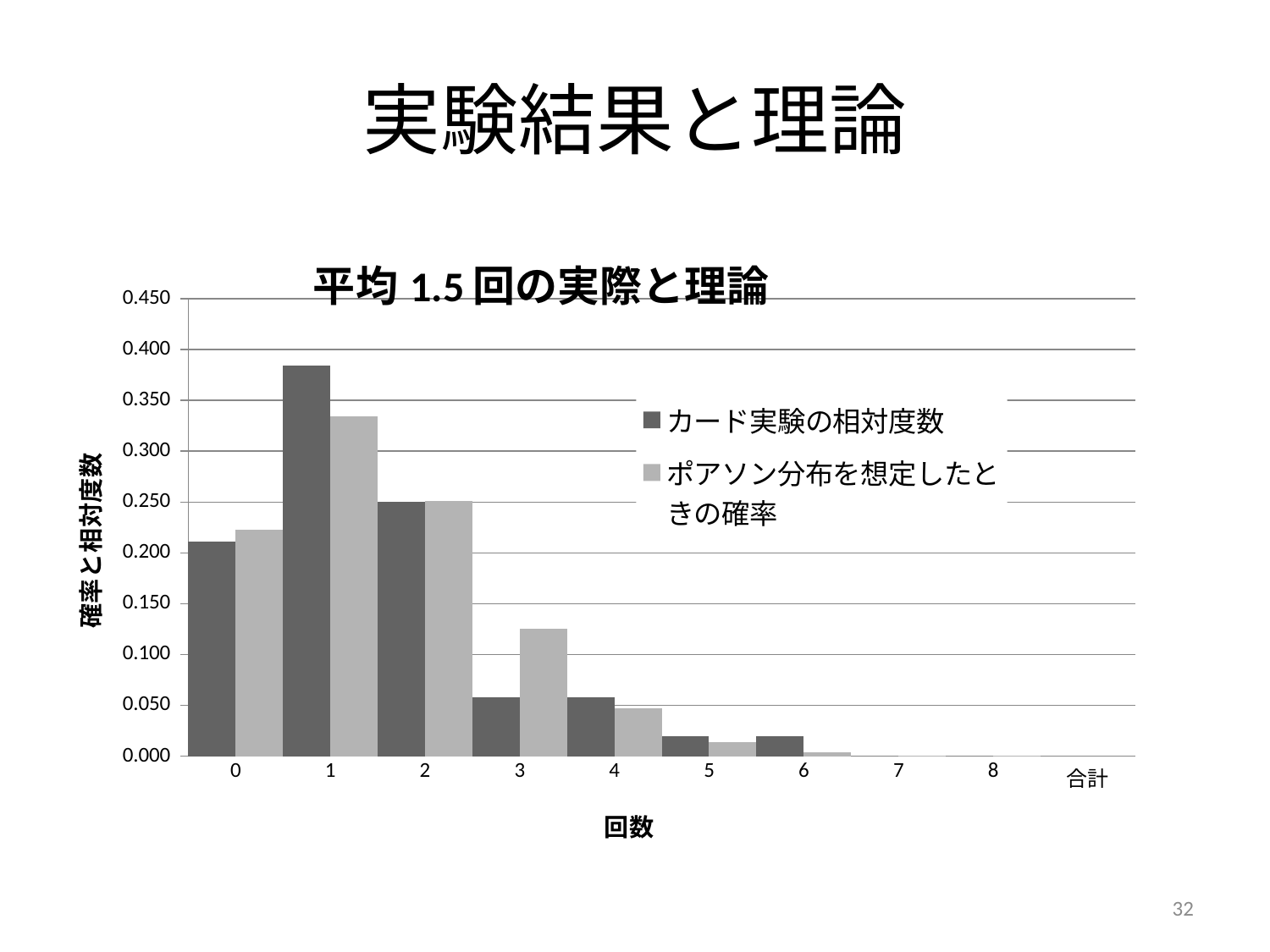
How many categories are shown on the x axis? 10 At 回数 = 3, which series has the larger value, カード実験の相対度数 or ポアソン分布を想定したときの確率? ポアソン分布を想定したときの確率 What is the title of the chart? 平均 1.5 回の実際と理論 What kind of chart is shown on the slide? bar chart Is the value of カード実験の相対度数 at 回数 = 1 greater or less than 0.350? greater Is the value of ポアソン分布を想定したときの確率 at 回数 = 3 greater or less than 0.100? greater What is the label of the x axis? 回数 For the series カード実験の相対度数, which 回数 category has the highest value? 1 For the series ポアソン分布を想定したときの確率, which 回数 category has the highest value? 1 Do the values of ポアソン分布を想定したときの確率 rise or fall from 回数 = 1 to 回数 = 6? fall At 回数 = 1, which series has the larger value, カード実験の相対度数 or ポアソン分布を想定したときの確率? カード実験の相対度数 How many series does the legend list? 2